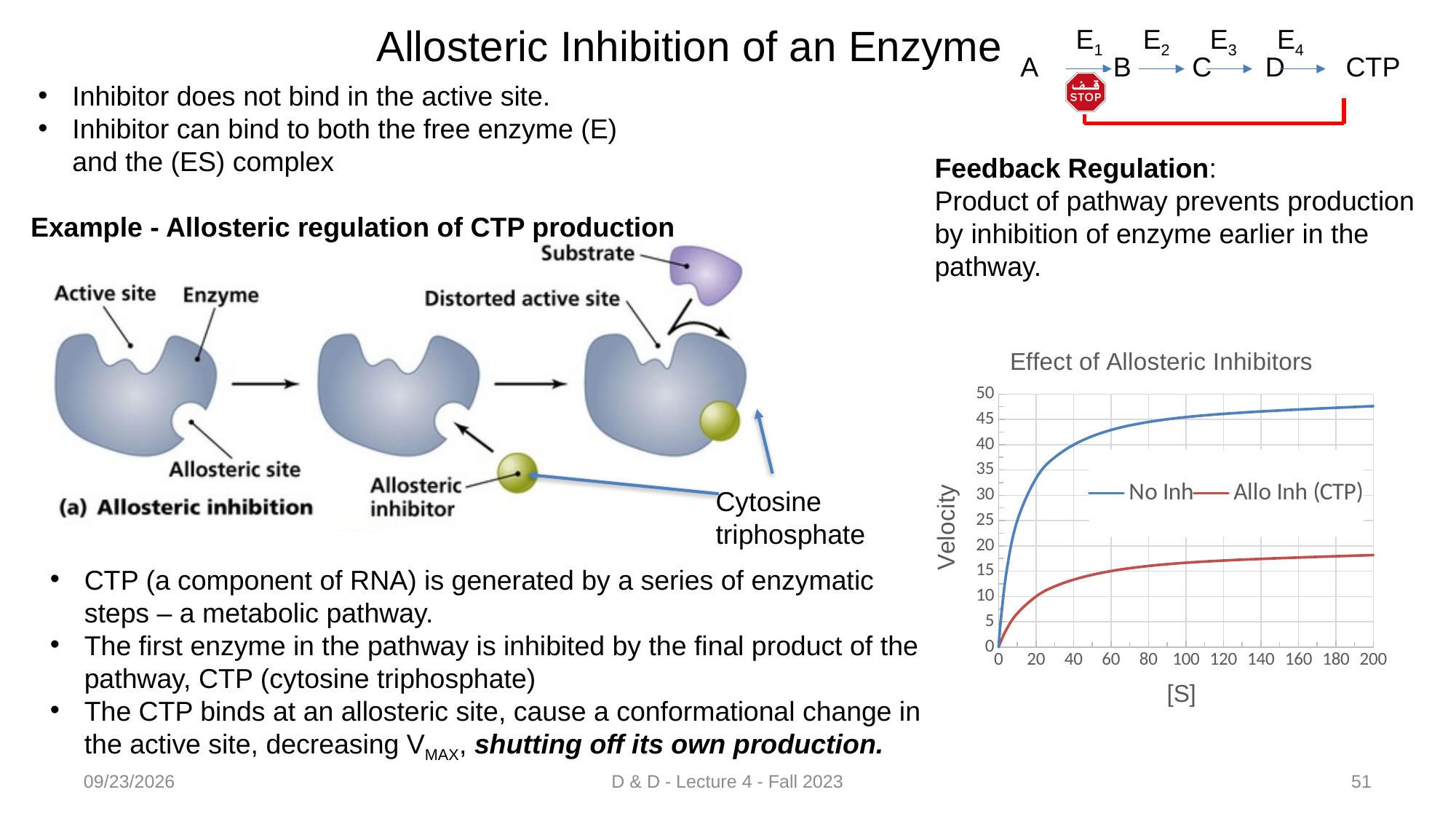
What kind of chart is 'Effect of Allosteric Inhibitors'? line chart In the 'Effect of Allosteric Inhibitors' chart, is the velocity for No Inh at [S] = 100 greater or less than 40? greater In the 'Effect of Allosteric Inhibitors' chart, is the velocity for Allo Inh (CTP) at [S] = 200 greater or less than 15? greater In the 'Effect of Allosteric Inhibitors' chart, is the velocity for Allo Inh (CTP) at [S] = 200 greater or less than 20? less In the 'Effect of Allosteric Inhibitors' chart, which series is the lower curve across the whole [S] range? Allo Inh (CTP) In the 'Effect of Allosteric Inhibitors' chart, which series has the higher velocity at [S] = 200, No Inh or Allo Inh (CTP)? No Inh What are the two series named in the legend of the 'Effect of Allosteric Inhibitors' chart? No Inh and Allo Inh (CTP) What is the title of the chart on the slide? Effect of Allosteric Inhibitors How many series does the legend of the 'Effect of Allosteric Inhibitors' chart list? 2 In the 'Effect of Allosteric Inhibitors' chart, does the velocity for No Inh rise or fall as [S] increases? rise